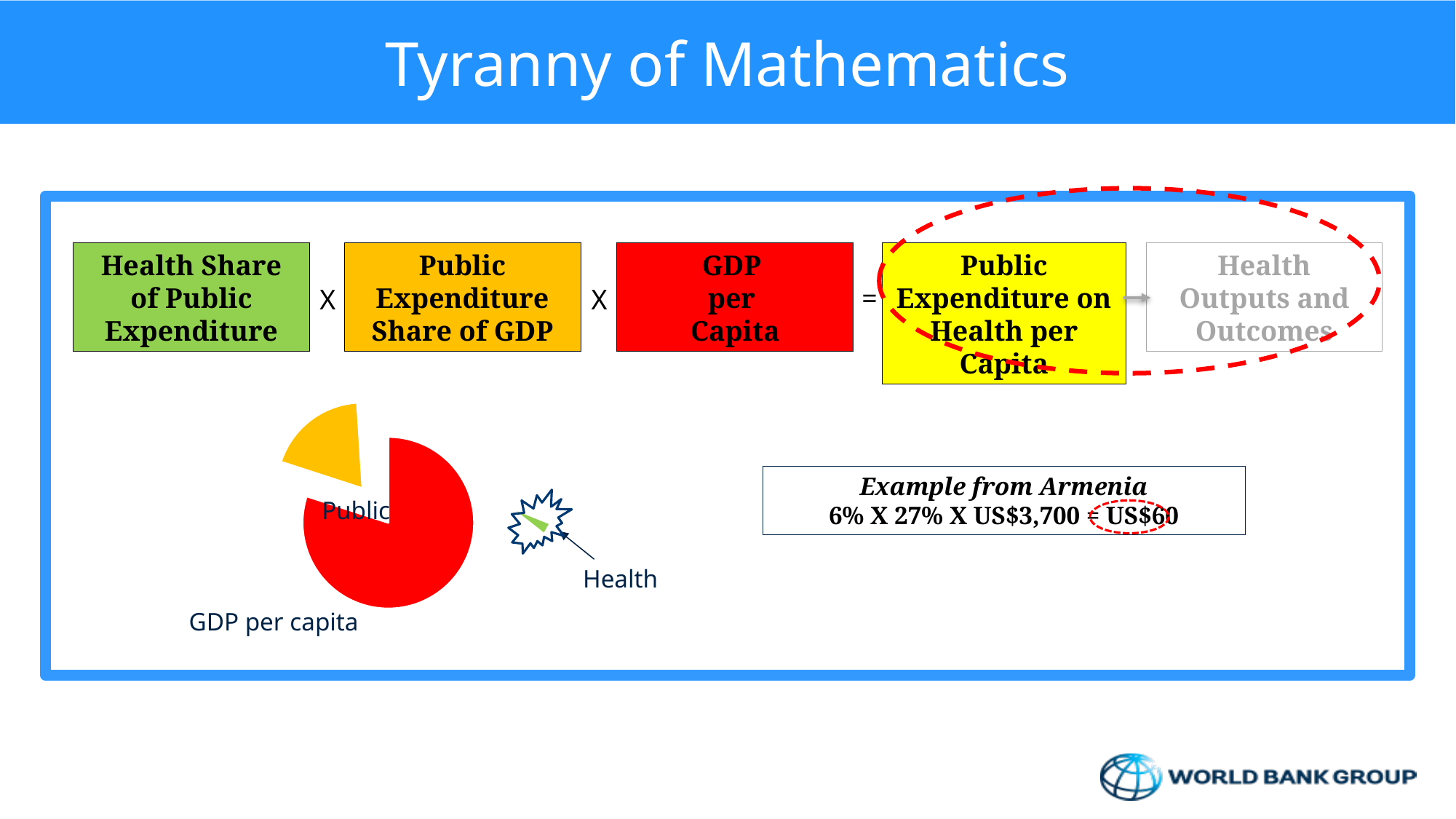
What colour is the GDP per capita slice in the pie chart? red Which slice of the pie chart is pulled out (exploded) from the rest of the pie? Public How many slices does the pie chart have? 3 In the pie chart, which slice is larger, GDP per capita or Public? GDP per capita Which slice of the pie chart is the smallest? Health Which slice of the pie chart is the largest? GDP per capita In the pie chart, which slice is larger, Public or Health? Public What kind of chart is shown on the slide? pie chart